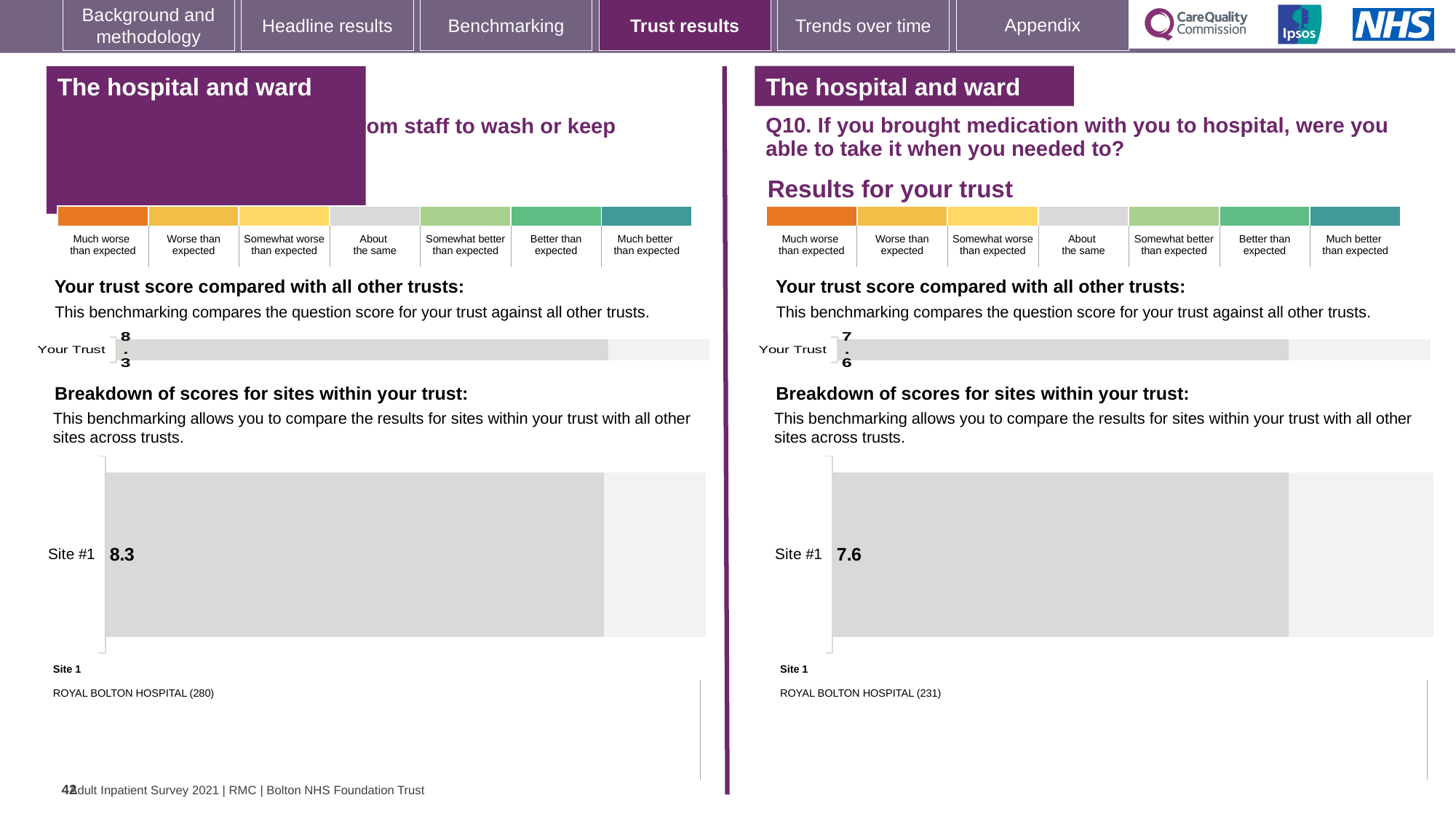
Which site is listed as Site 1 under the left-hand breakdown chart? ROYAL BOLTON HOSPITAL (280) What kind of chart is used to show the Site #1 score on the right half of the slide? Bar chart On the right half of the slide (Q10), what is the score shown for Your Trust in the 'Your trust score compared with all other trusts' chart? 7.6 In the left-hand 'Breakdown of scores for sites within your trust' chart, what is the score for Site #1? 8.3 How many sites are shown in the right-hand 'Breakdown of scores for sites within your trust' chart? 1 On the left half of the slide, what is the score shown for Your Trust in the 'Your trust score compared with all other trusts' chart? 8.3 What is the difference between the Site #1 score on the left half of the slide and the Site #1 score on the right half (Q10)? 0.7 Which site is listed as Site 1 under the right-hand breakdown chart for Q10? ROYAL BOLTON HOSPITAL (231) Is the Your Trust score on the right half of the slide (Q10) the same as its Site #1 score? Yes, both are 7.6 How many sites are shown in the left-hand 'Breakdown of scores for sites within your trust' chart? 1 In the right-hand 'Breakdown of scores for sites within your trust' chart for Q10, what is the score for Site #1? 7.6 Which is larger: the Your Trust score on the left half of the slide or the Your Trust score on the right half (Q10)? Left half (8.3)